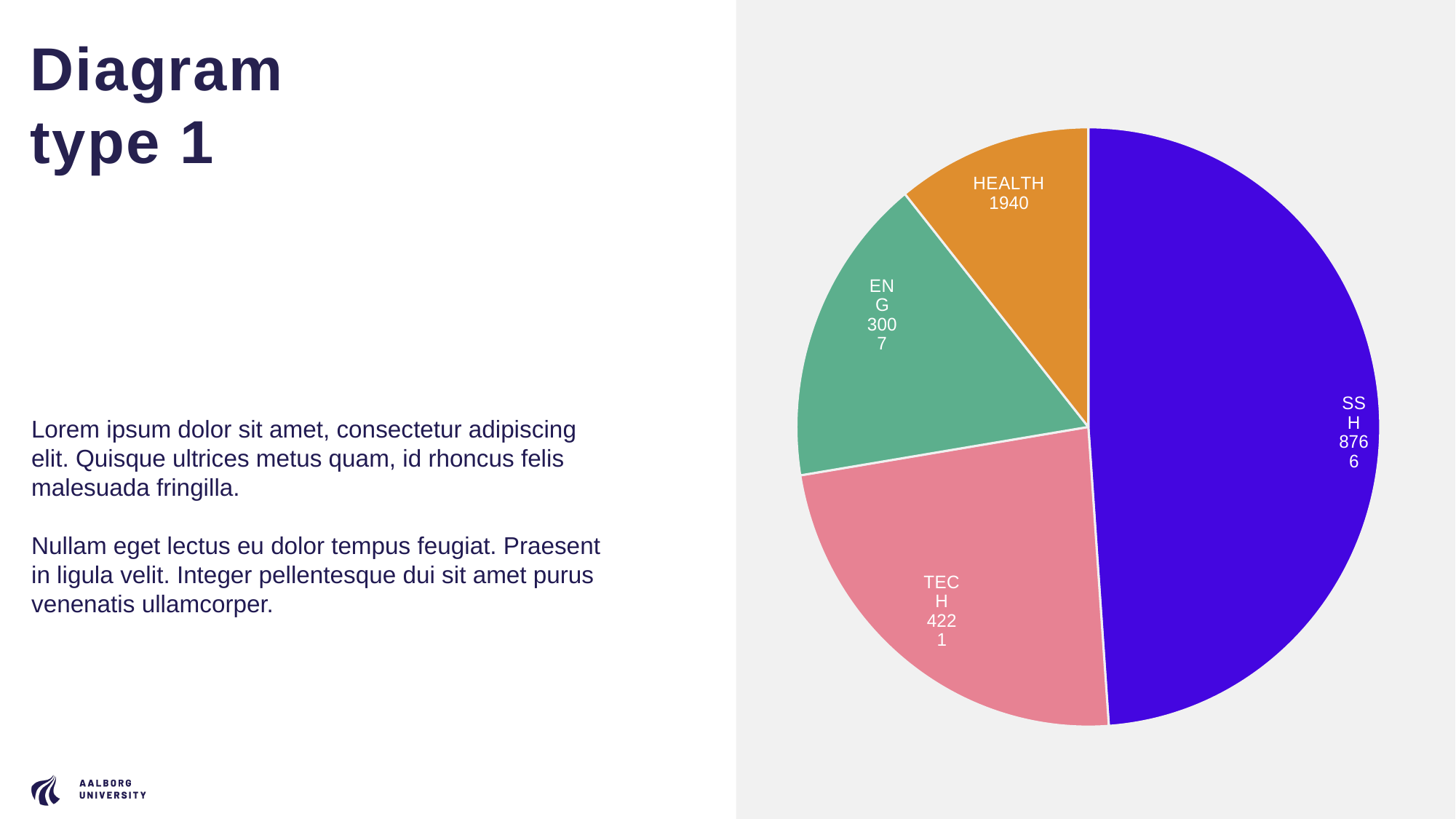
What is the difference between the SSH value and the TECH value in the pie chart? 4545 What value is shown for the SSH slice of the pie chart? 8766 What value is shown for the HEALTH slice of the pie chart? 1940 How many slices does the pie chart have? 4 What value is shown for the ENG slice of the pie chart? 3007 Which slice of the pie chart has the smallest value? HEALTH Which is larger in the pie chart, TECH or ENG? TECH What kind of chart is shown on the slide? Pie chart What is the difference between the ENG value and the HEALTH value in the pie chart? 1067 What colour is the SSH slice of the pie chart? Blue What value is shown for the TECH slice of the pie chart? 4221 Which slice of the pie chart has the largest value? SSH